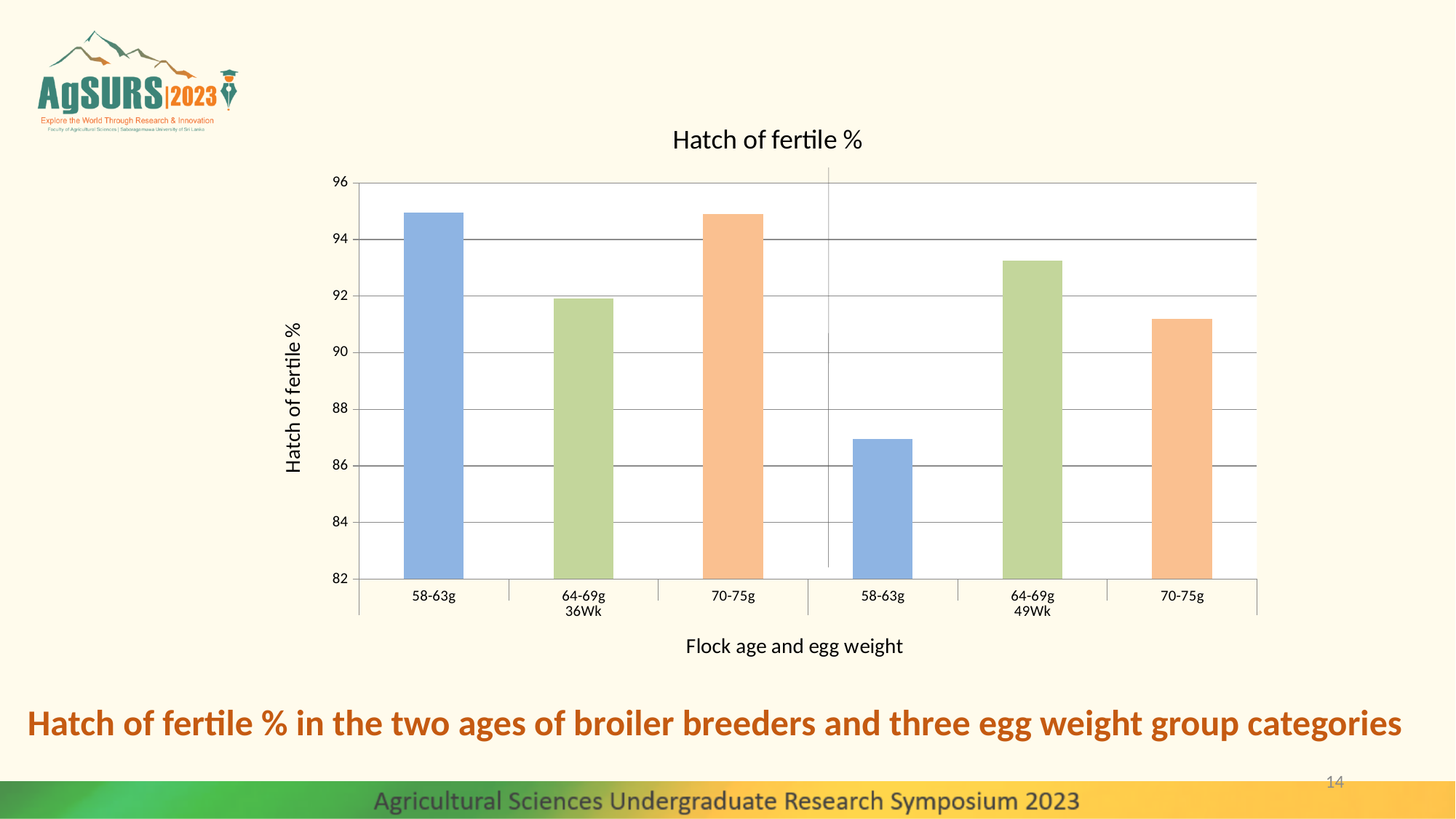
What is the title of the chart? Hatch of fertile % Which is larger, the value for 64-69g at 36Wk or the value for 64-69g at 49Wk? 64-69g at 49Wk What type of chart is shown on the slide? bar chart Is the value for 64-69g at 49Wk greater or less than 92? greater How many bars are plotted in the chart? 6 Is the value for 58-63g at 36Wk greater or less than 94? greater Is the value for 58-63g at 49Wk greater or less than 88? less What is the label of the x axis of the chart? Flock age and egg weight Which bar has the lowest hatch of fertile %? 58-63g at 49Wk Which is larger, the value for 70-75g at 36Wk or the value for 70-75g at 49Wk? 70-75g at 36Wk